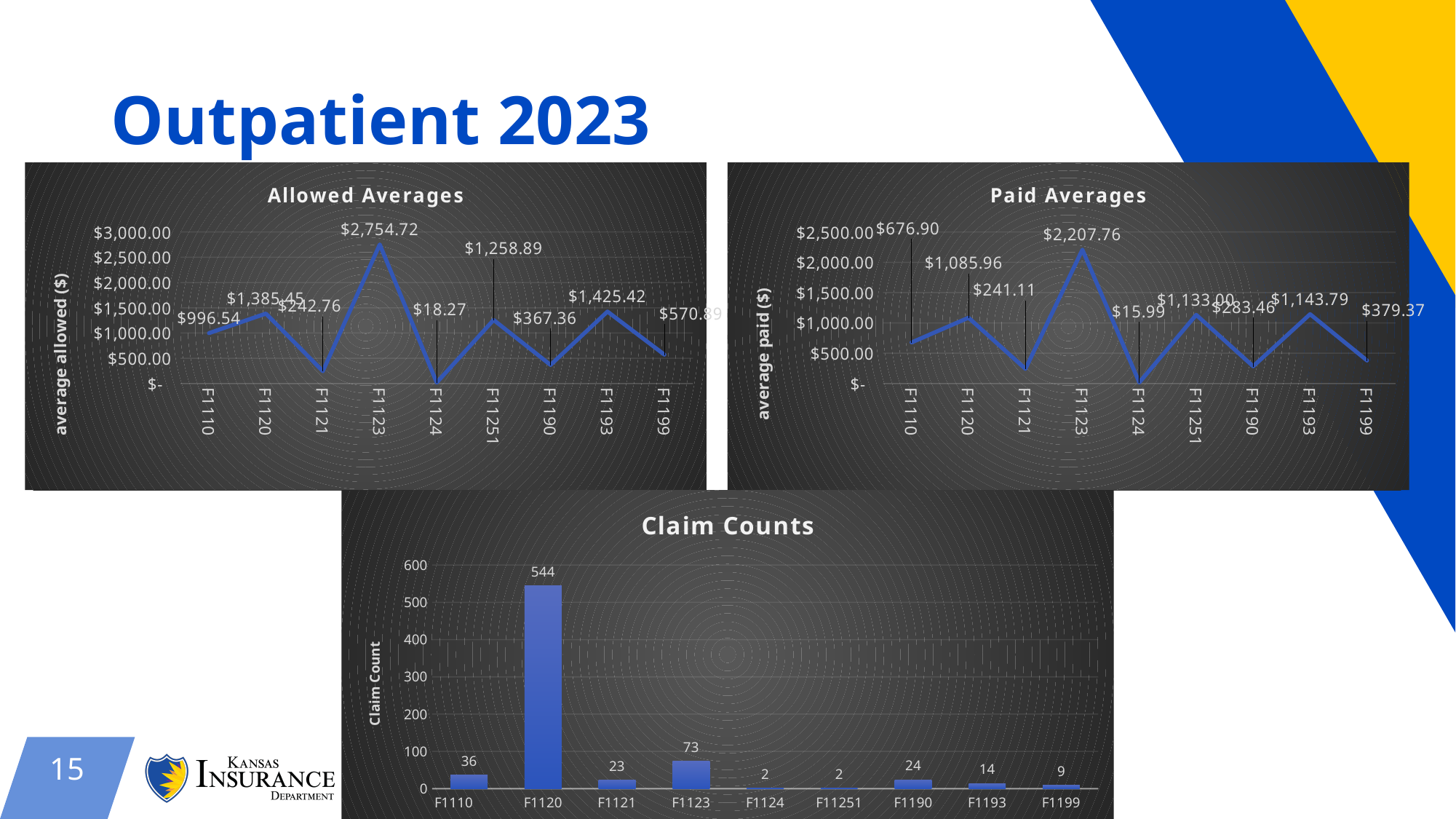
In the Allowed Averages chart, what is the average allowed for F1193? $1,425.42 In the Claim Counts chart, how many claims does F1120 have? 544 In the Allowed Averages chart, what is the average allowed for F1123? $2,754.72 What kind of chart is the Claim Counts chart? Bar chart In the Paid Averages chart, which category has the highest average paid? F1123 In the Claim Counts chart, which has more claims, F1190 or F1193? F1190 In the Paid Averages chart, what is the average paid for F1199? $379.37 In the Claim Counts chart, which category has the highest claim count? F1120 In the Claim Counts chart, what is the difference in claim count between F1123 and F1110? 37 In the Allowed Averages chart, which category has the lowest average allowed? F1124 How many categories are shown on the x axis of the Claim Counts chart? 9 In the Paid Averages chart, what is the average paid for F1120? $1,085.96